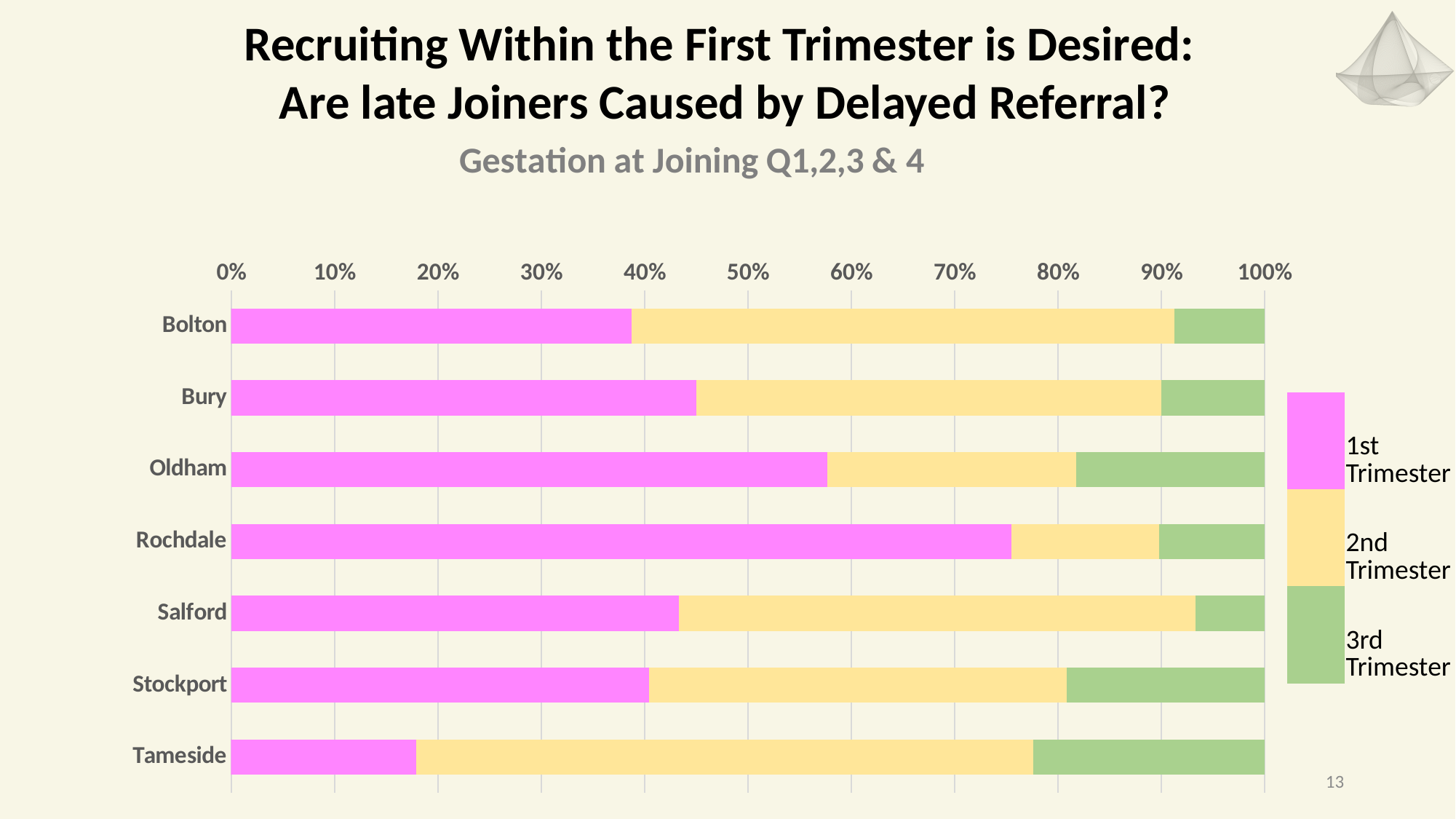
Is the 1st Trimester value for Oldham greater or less than 50%? greater How many areas (categories) are shown on the chart? 7 What kind of chart is shown on the slide? Stacked bar chart Is the 1st Trimester value for Tameside greater or less than 20%? less Which area has the highest share of joiners in the 1st Trimester? Rochdale Is the 1st Trimester value for Rochdale greater or less than 70%? greater Which colour represents the 3rd Trimester in the legend? Green What is the title of the chart? Gestation at Joining Q1,2,3 & 4 Which has the larger 1st Trimester share, Oldham or Bury? Oldham Which area has the lowest share of joiners in the 1st Trimester? Tameside Which has the larger 3rd Trimester share, Tameside or Bolton? Tameside How many series does the legend list? 3